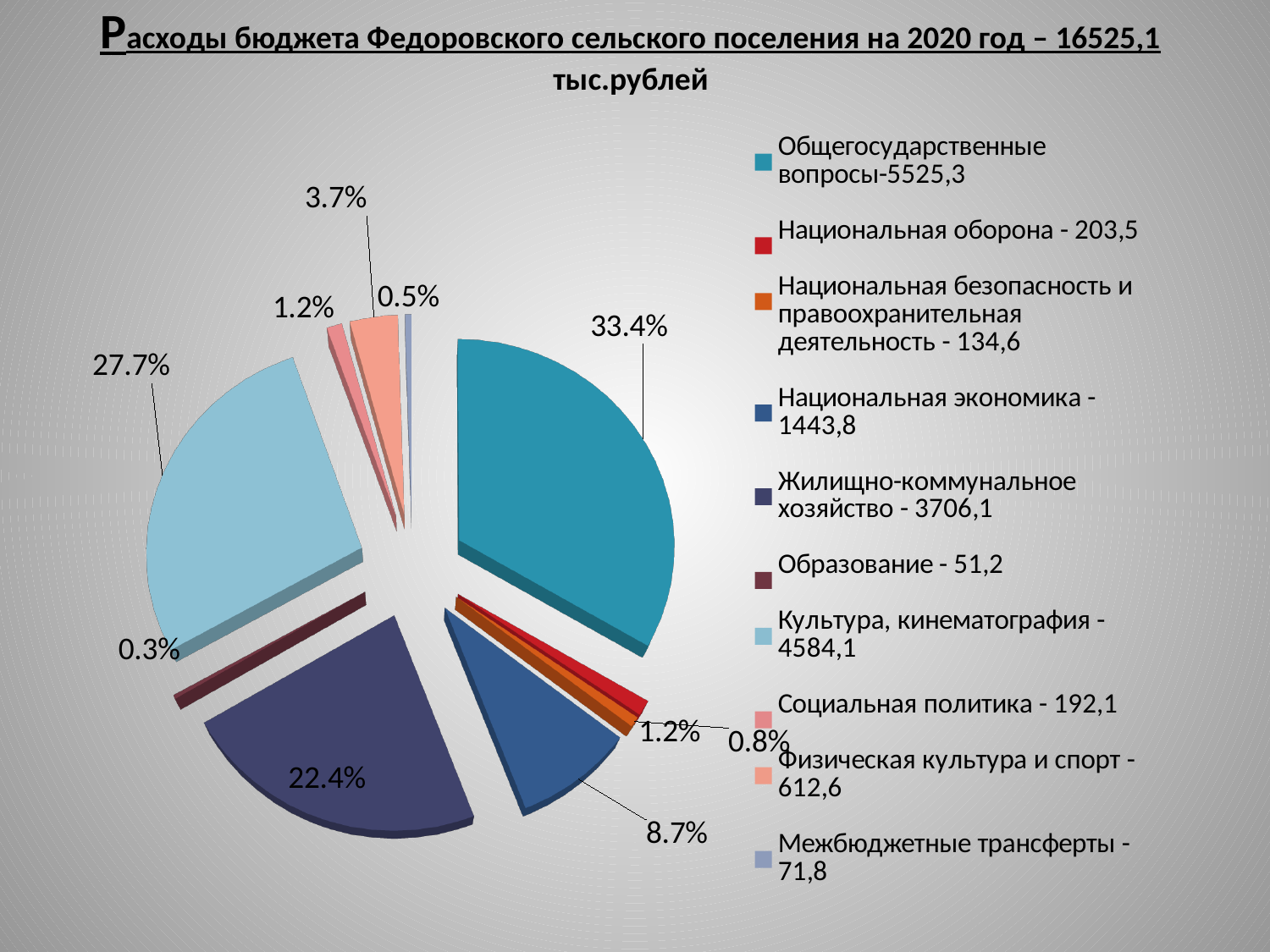
Which is larger, the value for Национальная оборона or the value for Социальная политика? Национальная оборона Which category has the largest share of the pie? Общегосударственные вопросы What total budget expenditure is stated in the chart title? 16525,1 тыс.рублей What value is given in the legend for Физическая культура и спорт? 612,6 What share of the pie does Жилищно-коммунальное хозяйство take? 22.4% What kind of chart is shown on the slide? Pie chart What share of the pie does Культура, кинематография take? 27.7% What is the difference between the values for Общегосударственные вопросы and Культура, кинематография? 941,2 How many categories does the legend of the pie chart list? 10 What value is given in the legend for Межбюджетные трансферты? 71,8 What share of the pie does Национальная экономика take? 8.7% Which category has the smallest share of the pie? Образование